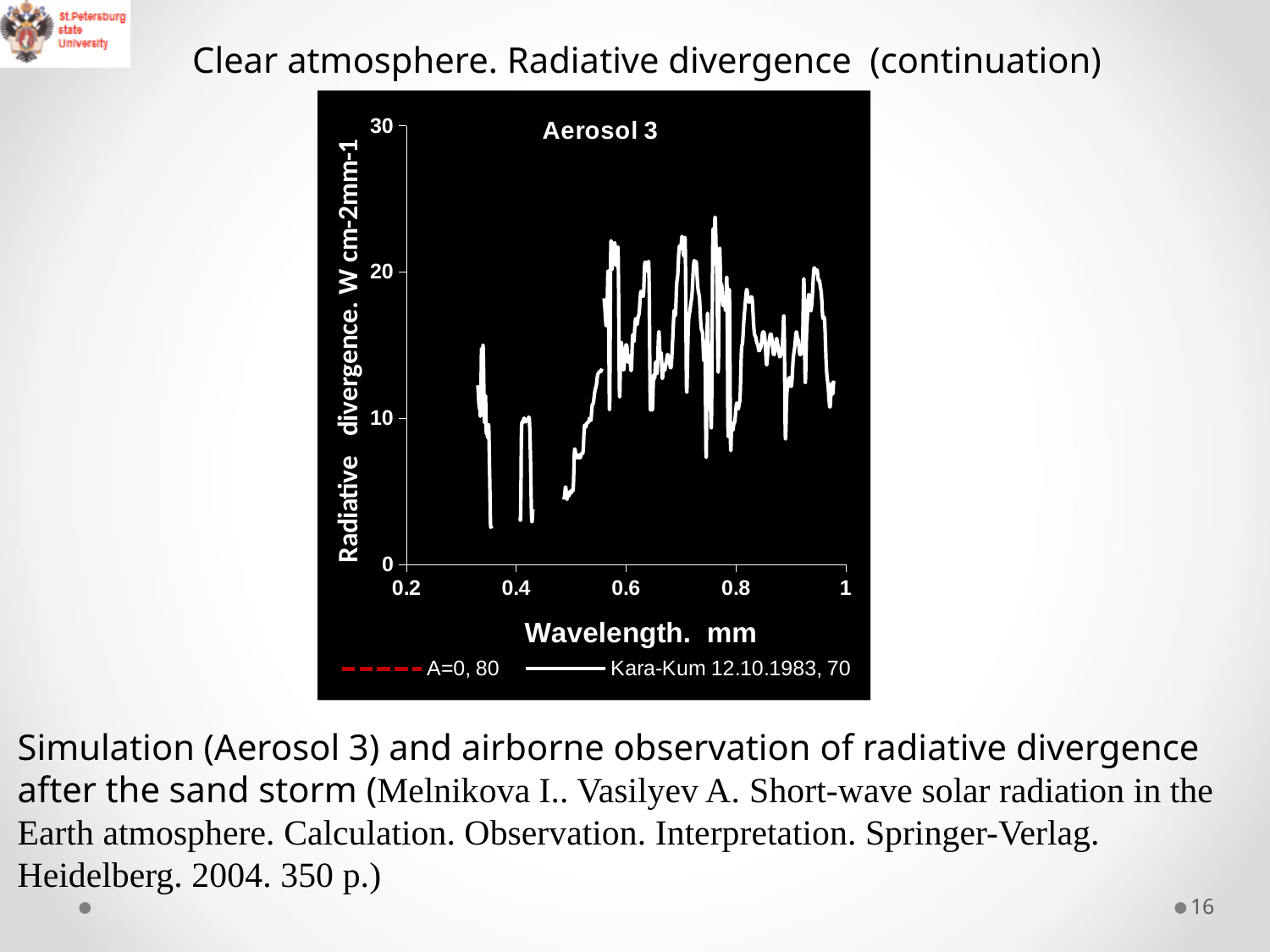
Does the Kara-Kum 12.10.1983, 70 series generally rise or fall as wavelength increases from 0.45 to 0.6? rise What kind of chart is shown on the slide? line chart Is the highest value reached by the Kara-Kum 12.10.1983, 70 series greater or less than 20? greater Is the lowest value reached by the Kara-Kum 12.10.1983, 70 series greater or less than 10? less How many series does the chart legend list? 2 Is the highest value reached by the Kara-Kum 12.10.1983, 70 series greater or less than 30? less What is the title printed inside the chart? Aerosol 3 What are the two series named in the chart legend? A=0, 80 and Kara-Kum 12.10.1983, 70